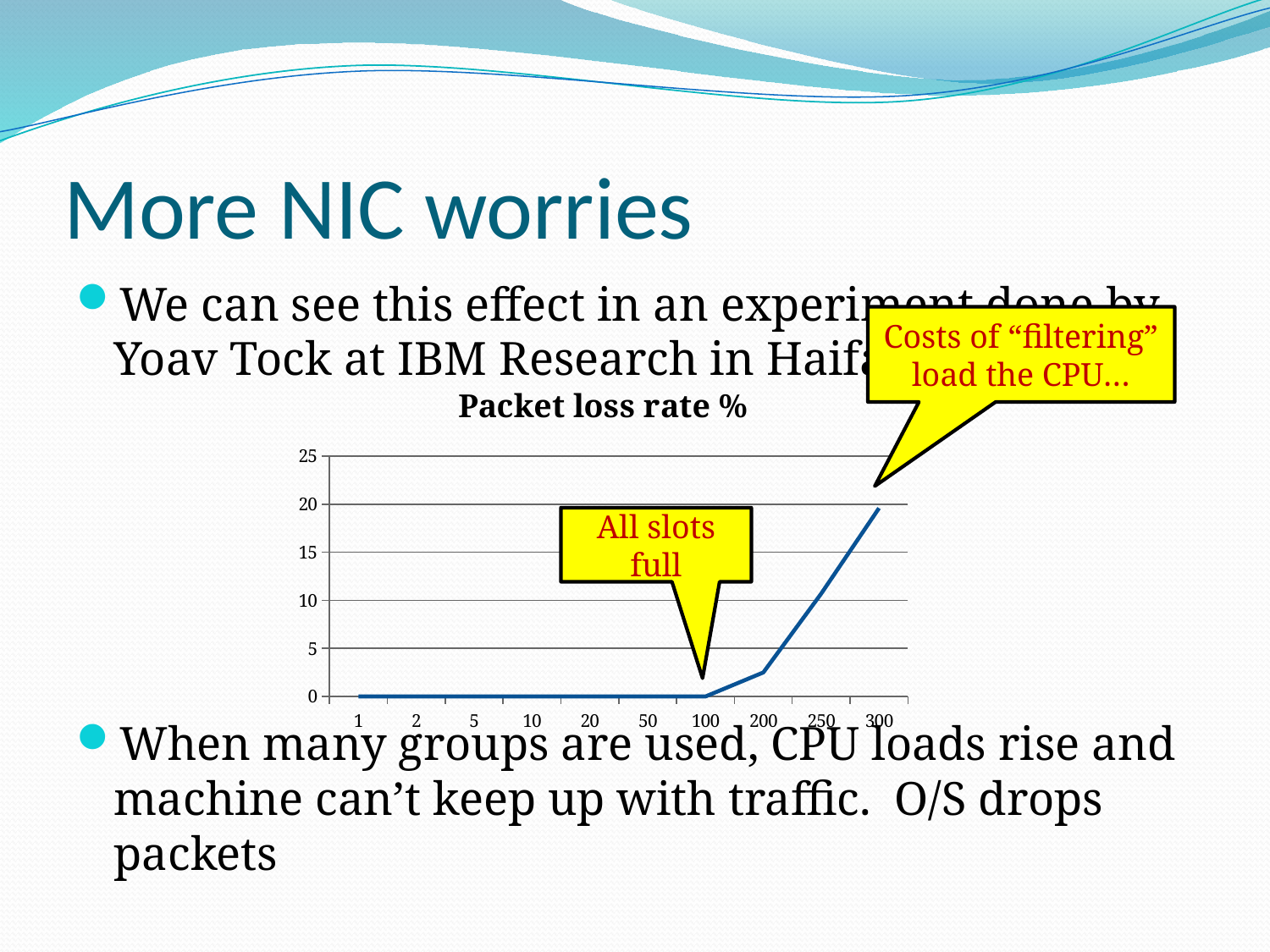
What does the callout pointing at the 100 mark on the chart say? All slots full Does the packet loss rate rise or fall as the x-axis values increase from 100 to 300? rise How many categories are shown on the x axis of the chart? 10 Is the packet loss rate at 300 greater or less than 15? greater What is the packet loss rate at x-axis category 1? 0 What kind of chart is shown on the slide? line chart What is the title of the chart? Packet loss rate % Which has a higher packet loss rate, 200 or 300? 300 Is the packet loss rate at 200 greater or less than 5? less Which x-axis category has the highest packet loss rate? 300 Is the packet loss rate at 250 greater or less than 5? greater What is the packet loss rate at x-axis category 50? 0